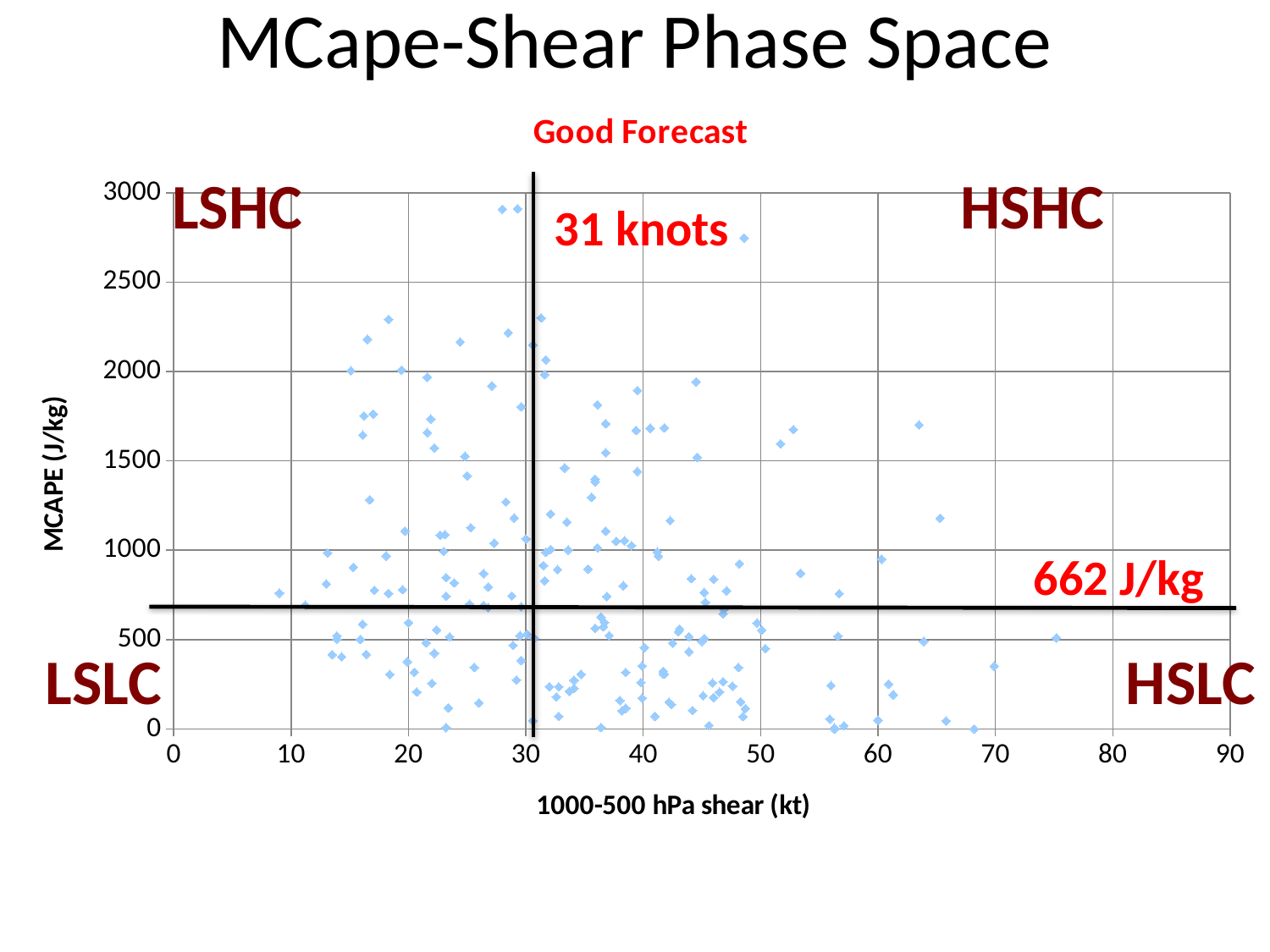
Is the lowest MCAPE value plotted on the chart greater or less than 500? less What shear value does the vertical reference line on the chart mark? 31 knots What kind of chart is shown on the slide? scatter plot Is the highest MCAPE value plotted on the chart greater or less than 2500? greater What MCAPE value does the horizontal reference line on the chart mark? 662 J/kg